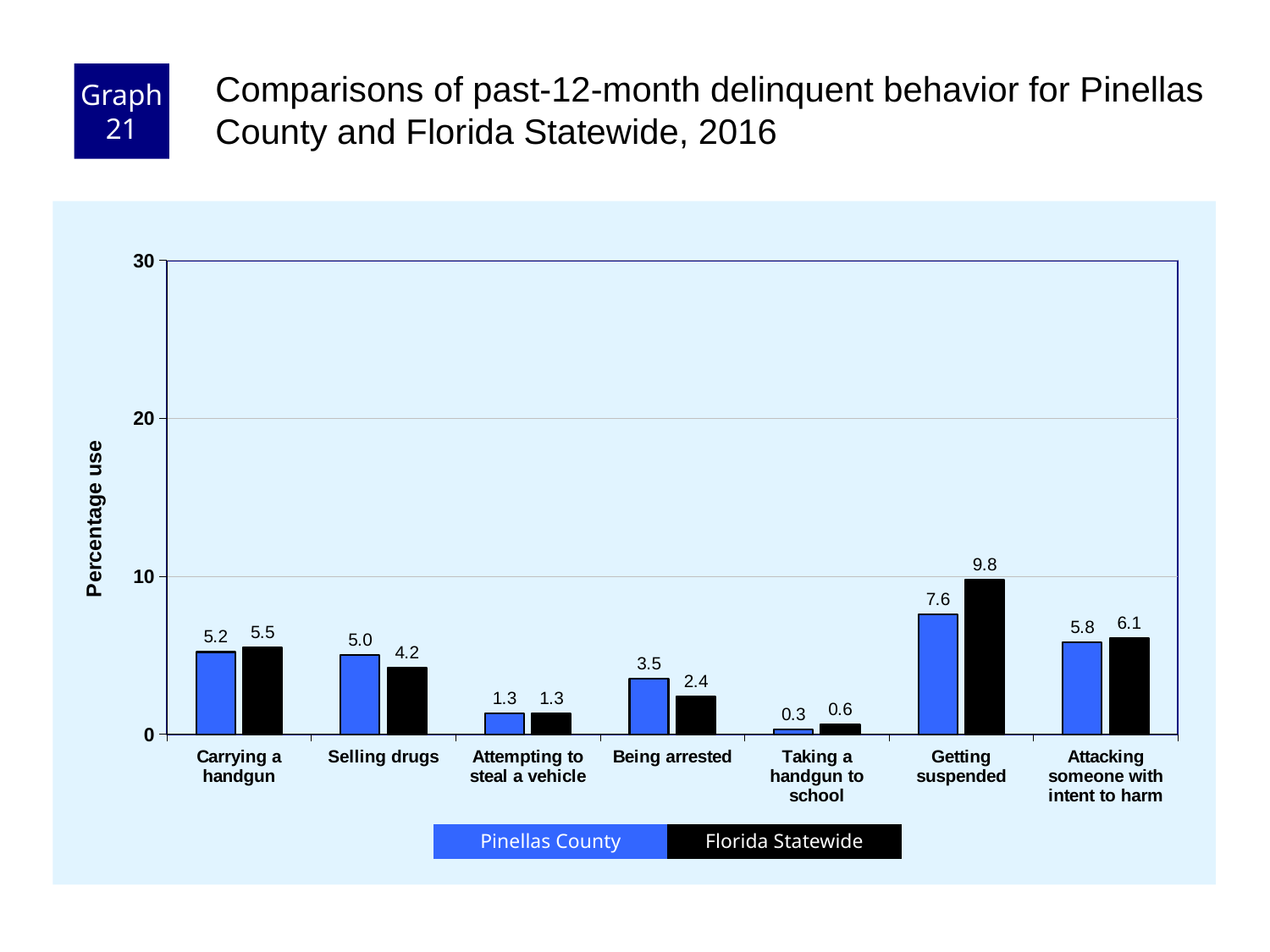
Which category has the lowest Pinellas County value? Taking a handgun to school How many series does the legend list? 2 What is the Pinellas County value for Taking a handgun to school? 0.3 Which is larger for Selling drugs: the Pinellas County value or the Florida Statewide value? Pinellas County What is the difference between the Florida Statewide and Pinellas County values for Getting suspended? 2.2 What is the Florida Statewide value for Selling drugs? 4.2 What is the Pinellas County value for Getting suspended? 7.6 What kind of chart is shown on the slide? bar chart What is the difference between the Pinellas County and Florida Statewide values for Being arrested? 1.1 Which category has the highest Florida Statewide value? Getting suspended How many categories are shown on the x axis? 7 Is the Florida Statewide value for Getting suspended greater or less than 10? less